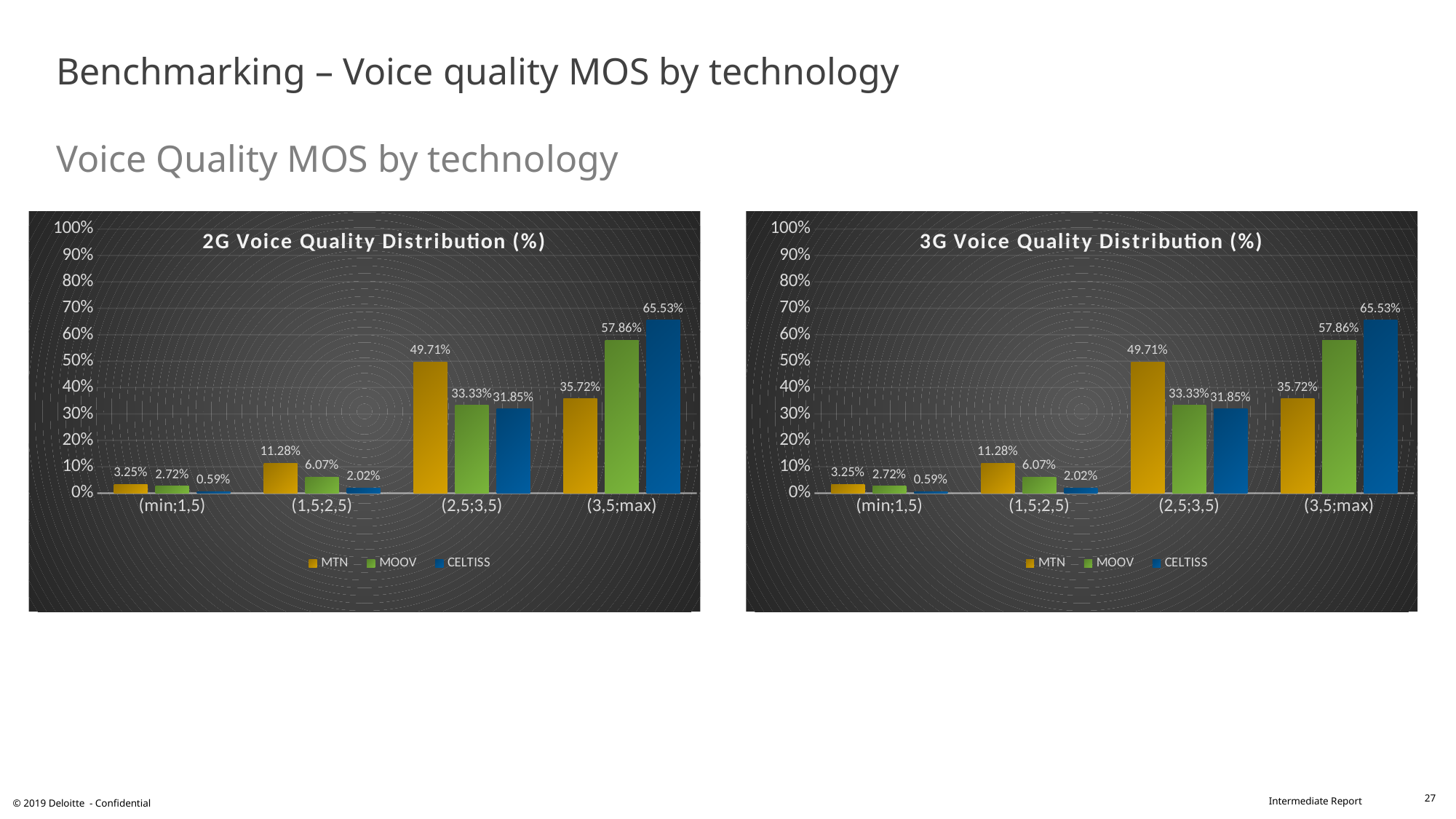
In the 2G Voice Quality Distribution (%) chart, what is the difference between MOOV and CELTISS in the (3,5;max) category? 7.67% In the 2G Voice Quality Distribution (%) chart, which series has the lowest value in the (min;1,5) category? CELTISS In the 2G Voice Quality Distribution (%) chart, what is the value for MOOV in the (1,5;2,5) category? 6.07% In the 3G Voice Quality Distribution (%) chart, what is the difference between MTN and MOOV in the (min;1,5) category? 0.53% What kind of chart is the 2G Voice Quality Distribution (%) chart? bar chart How many series does the legend of the 3G Voice Quality Distribution (%) chart list? 3 In the 3G Voice Quality Distribution (%) chart, which series has the highest value in the (3,5;max) category? CELTISS How many categories are shown on the x axis of the 2G Voice Quality Distribution (%) chart? 4 In the 2G Voice Quality Distribution (%) chart, what is the value for MTN in the (2,5;3,5) category? 49.71% In the 3G Voice Quality Distribution (%) chart, what is the value for CELTISS in the (3,5;max) category? 65.53% In the 3G Voice Quality Distribution (%) chart, which is larger in the (2,5;3,5) category: MOOV or CELTISS? MOOV In the 3G Voice Quality Distribution (%) chart, is the value for MTN in the (3,5;max) category greater or less than 40%? less